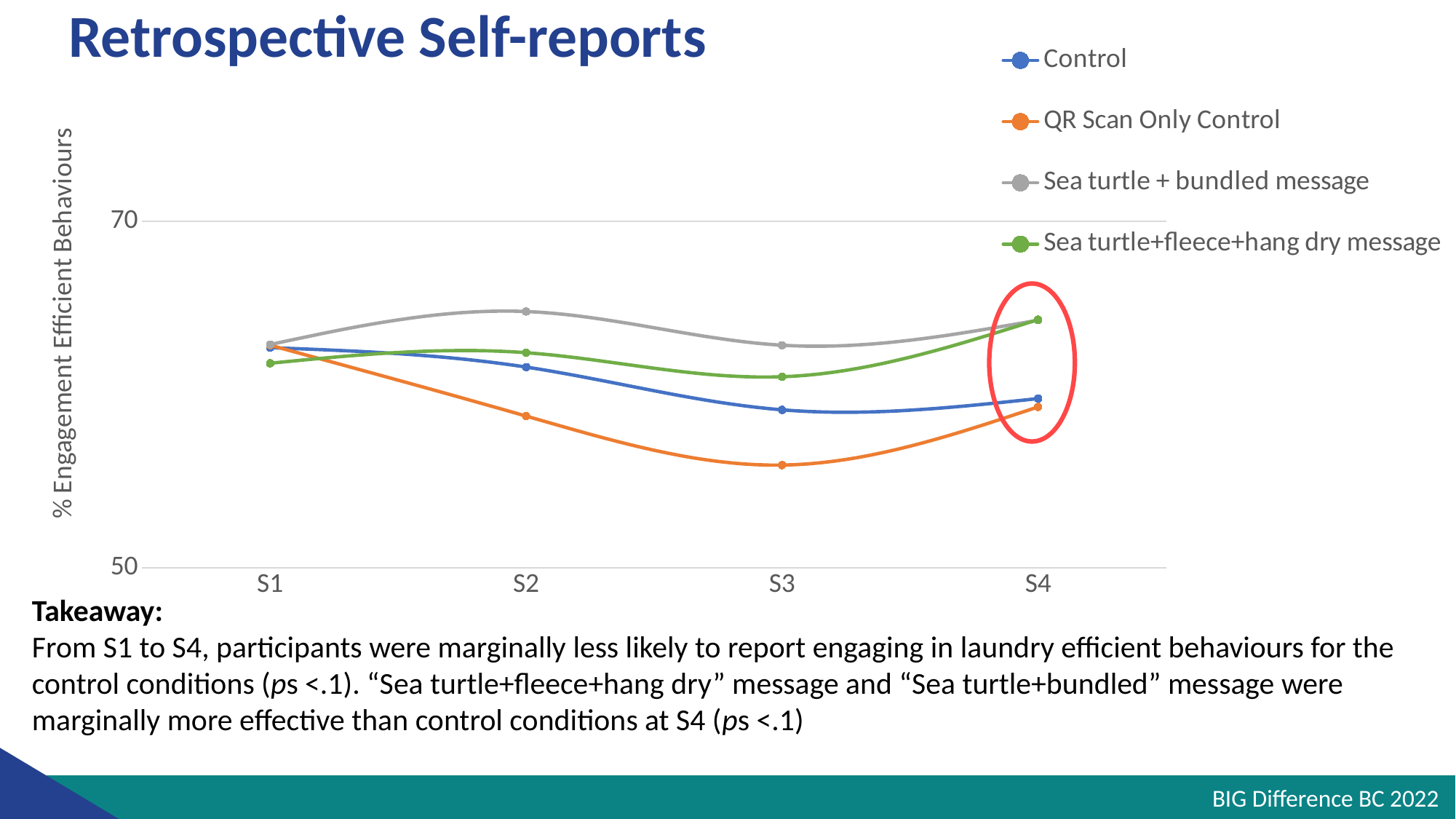
Is the value for Sea turtle + bundled message at S2 greater or less than 70? less Which series has the highest value at S2? Sea turtle + bundled message How many series does the legend list? 4 Does the QR Scan Only Control series rise or fall from S1 to S3? fall At S2, which is larger: QR Scan Only Control or Sea turtle+fleece+hang dry message? Sea turtle+fleece+hang dry message At S3, which is larger: Sea turtle + bundled message or Control? Sea turtle + bundled message What kind of chart is shown on the slide? line chart What colour is the Control series line? blue Does the Sea turtle+fleece+hang dry message series rise or fall from S3 to S4? rise What is the y-axis title of the chart? % Engagement Efficient Behaviours How many points are there along the x axis? 4 Which series has the lowest value at S3? QR Scan Only Control